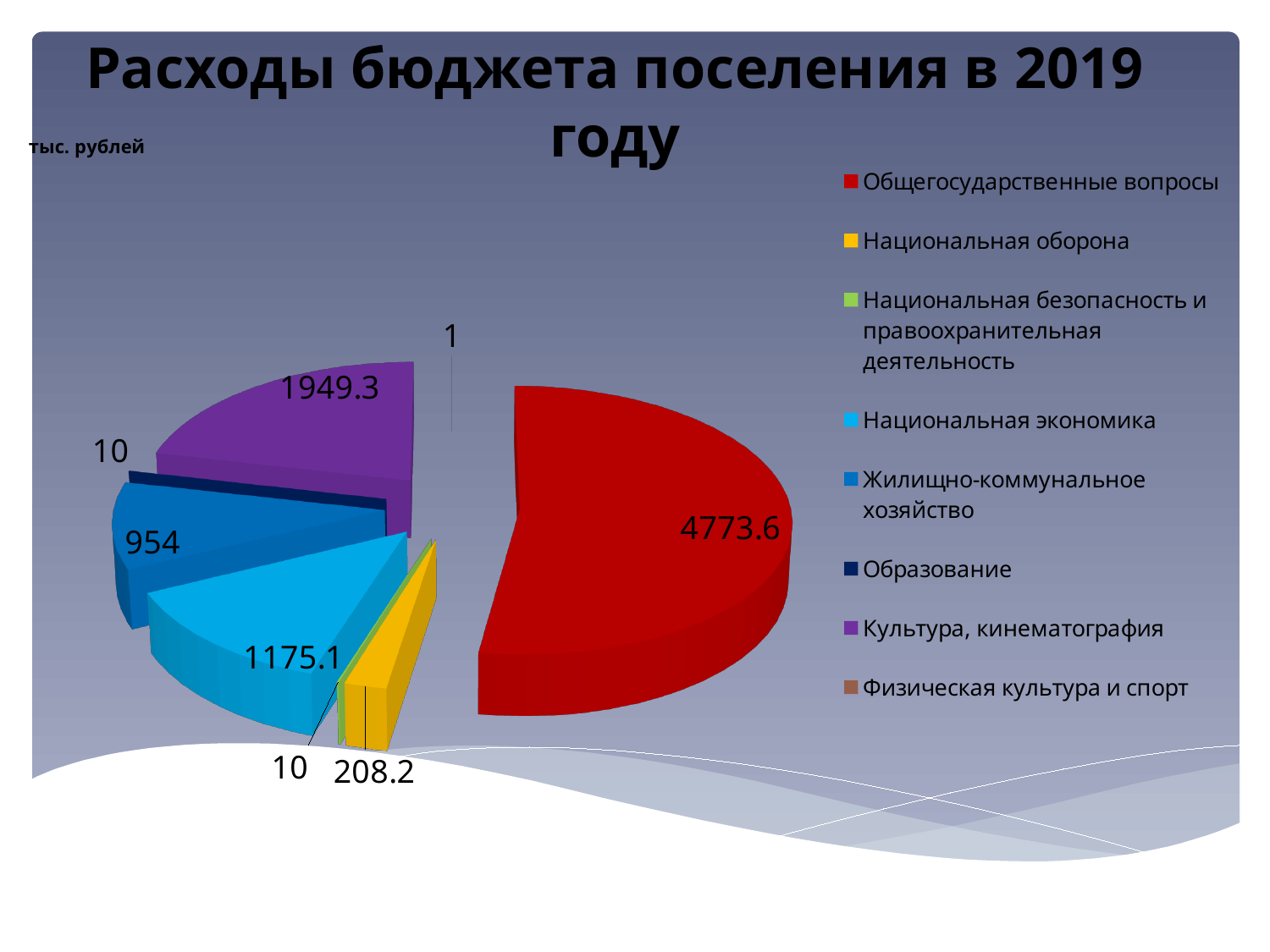
What is the value for Общегосударственные вопросы? 4773.6 What is the value for Жилищно-коммунальное хозяйство? 954 What unit is indicated for the values on the chart? тыс. рублей What is the value for Национальная экономика? 1175.1 Which is larger: Национальная экономика or Жилищно-коммунальное хозяйство? Национальная экономика What is the difference between the values for Общегосударственные вопросы and Культура, кинематография? 2824.3 How many categories does the legend list? 8 Which category has the largest slice of the pie? Общегосударственные вопросы What is the value for Национальная оборона? 208.2 Which category has the smallest value? Физическая культура и спорт What type of chart is shown on the slide? Pie chart What is the value for Культура, кинематография? 1949.3